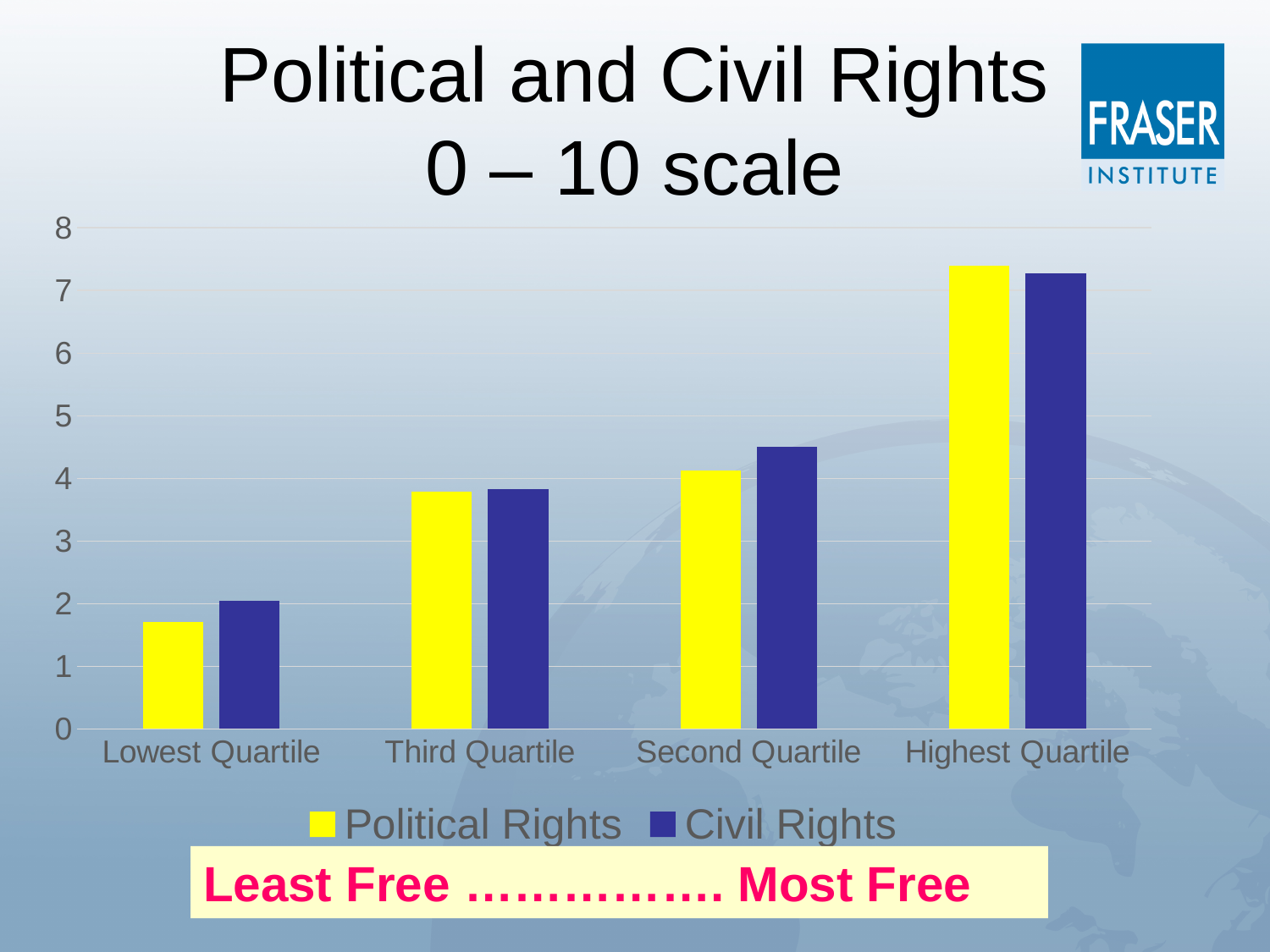
What kind of chart is shown on the slide? Bar chart Which colour represents Civil Rights in the legend? Blue How many series does the legend list? 2 How many categories are shown on the x axis? 4 In the Second Quartile, which is larger: Political Rights or Civil Rights? Civil Rights Is the Political Rights value for the Highest Quartile greater or less than 7? greater Is the Political Rights value for the Lowest Quartile greater or less than 2? less Is the Civil Rights value for the Second Quartile greater or less than 4? greater Which category has the highest Political Rights value? Highest Quartile Do the Political Rights values rise or fall from Lowest Quartile to Highest Quartile? Rise In the Lowest Quartile, which is larger: Political Rights or Civil Rights? Civil Rights Which category has the lowest Civil Rights value? Lowest Quartile